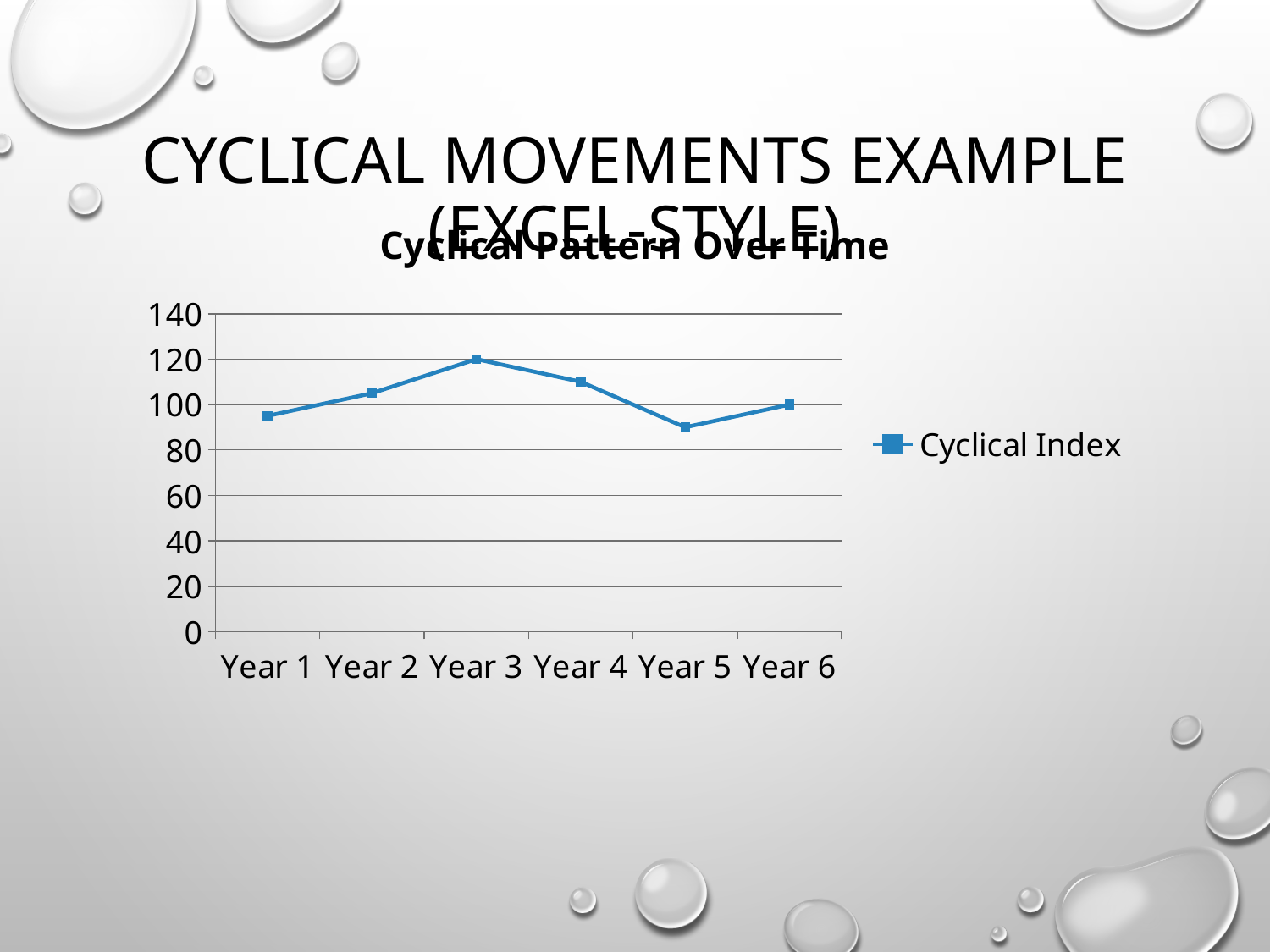
How many series does the chart's legend list? 1 How many years are plotted on the x axis of the chart? 6 Which year has the lowest Cyclical Index value? Year 5 What is the difference between the Cyclical Index values for Year 3 and Year 6? 20 Which year has the highest Cyclical Index value? Year 3 Is the Cyclical Index value for Year 1 greater or less than 100? less What kind of chart is shown on the slide? line chart What is the name of the series shown in the legend? Cyclical Index Which has the larger Cyclical Index value, Year 2 or Year 4? Year 4 Is the Cyclical Index value for Year 4 greater or less than 100? greater What is the Cyclical Index value for Year 3? 120 What is the Cyclical Index value for Year 6? 100